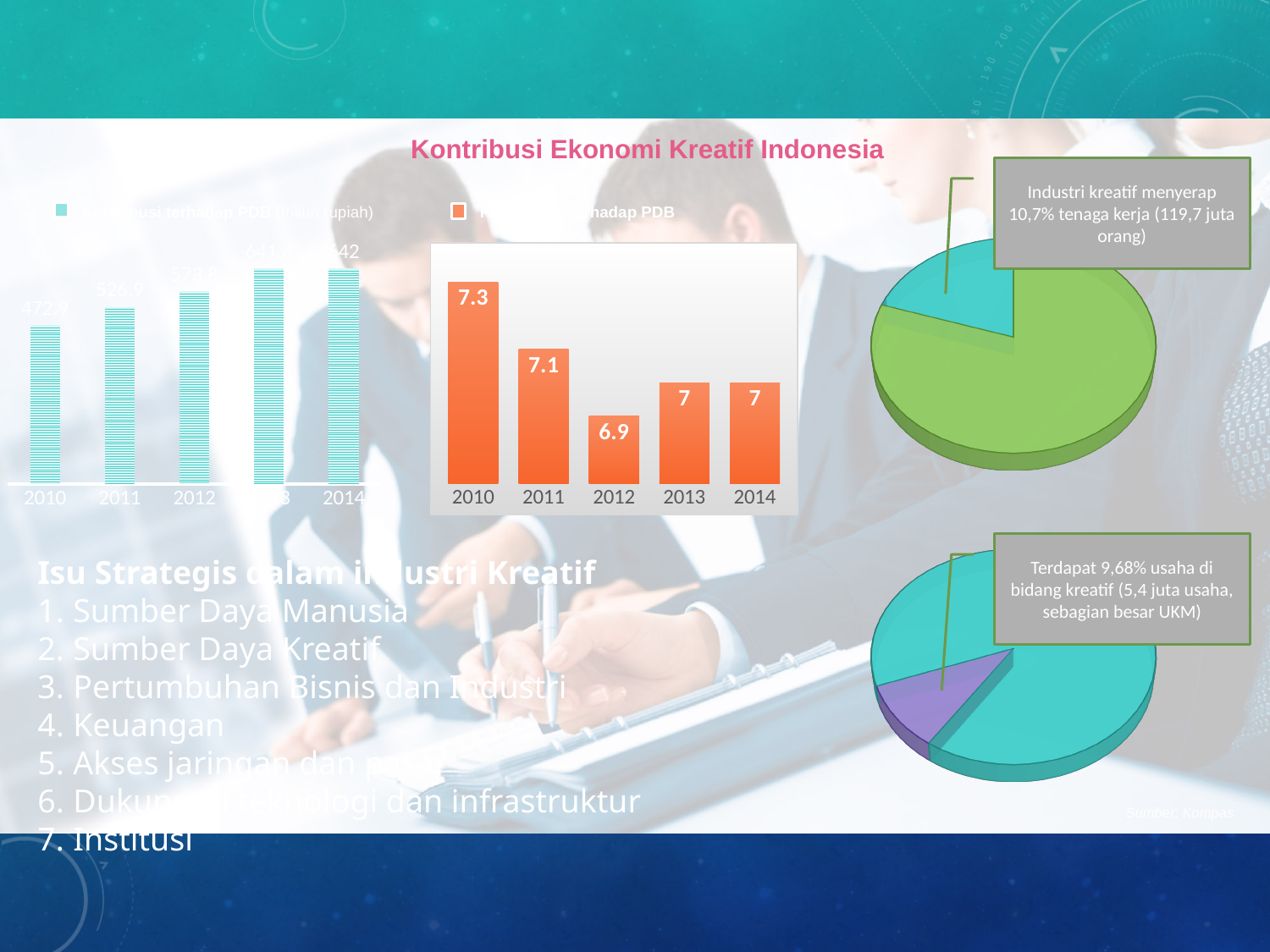
In the orange bar chart in the middle, do the values rise or fall from 2010 to 2012? fall In the teal bar chart on the left, what is the value for 2011? 526.9 In the orange bar chart in the middle, what is the value for 2014? 7 In the orange bar chart in the middle, which is larger, the value for 2011 or the value for 2013? 2011 What kind of chart is the orange chart in the middle of the slide? bar chart In the orange bar chart in the middle, which year has the highest value? 2010 How many years are shown on the x axis of the orange bar chart in the middle? 5 In the orange bar chart in the middle, which year has the lowest value? 2012 What is the title shown above the charts on the slide? Kontribusi Ekonomi Kreatif Indonesia In the orange bar chart in the middle, what is the value for 2012? 6.9 In the orange bar chart in the middle, what is the value for 2010? 7.3 In the orange bar chart in the middle, what is the difference between the 2010 and 2012 values? 0.4